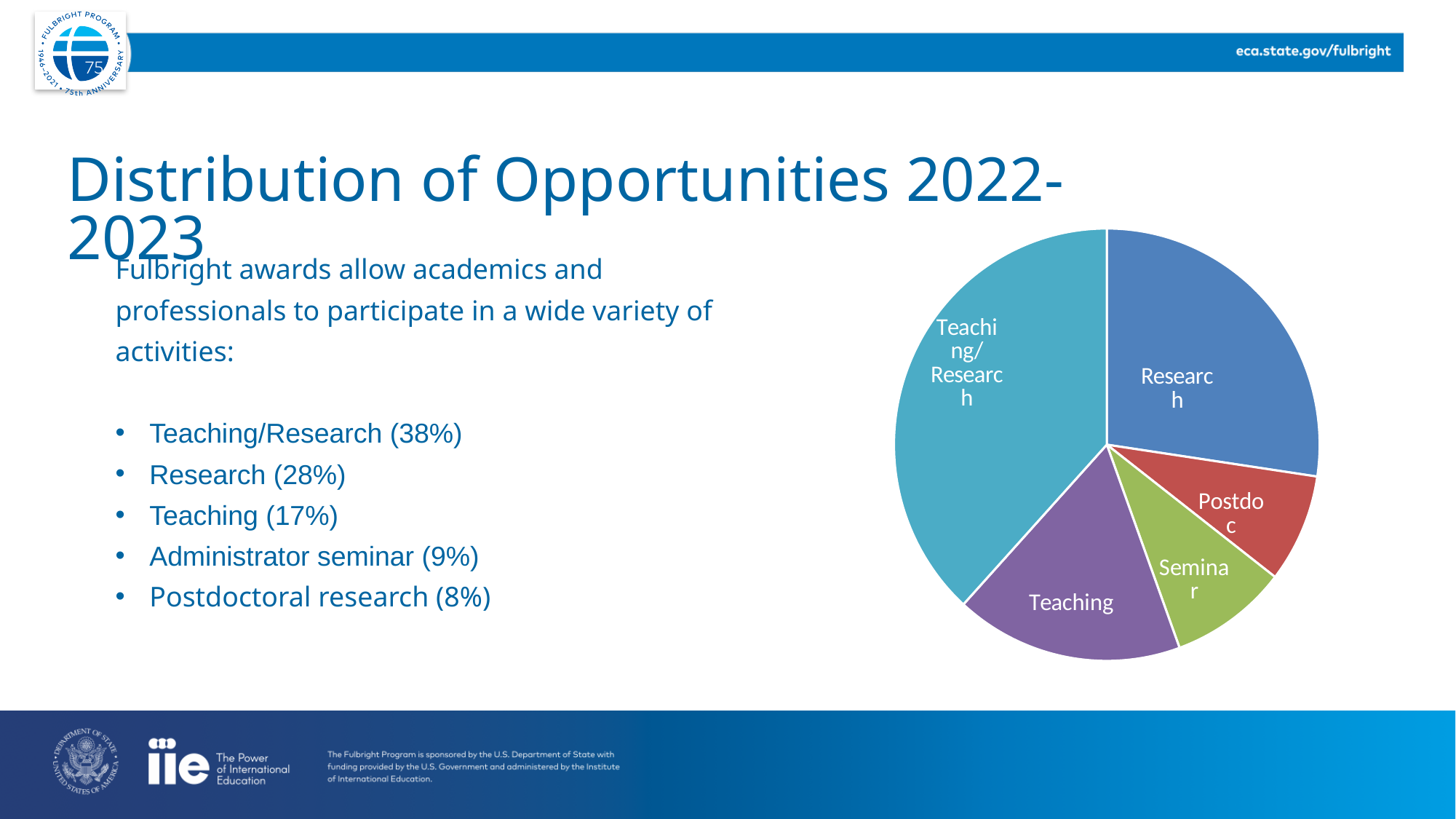
Which slice is larger, Research or Teaching? Research What share of the pie does the Research slice represent? 28% What colour is the Teaching slice of the pie chart? purple Which slice is larger, Teaching/Research or Teaching? Teaching/Research By how many percentage points does the Research share exceed the Teaching share? 11% Which slice of the pie chart is the largest? Teaching/Research What is the title of the slide containing the pie chart? Distribution of Opportunities 2022-2023 By how many percentage points does the Teaching/Research share exceed the Research share? 10% What kind of chart is shown on the slide? pie chart What share of the pie does the Teaching/Research slice represent? 38% How many slices does the pie chart have? 5 What share of the pie does the Teaching slice represent? 17%